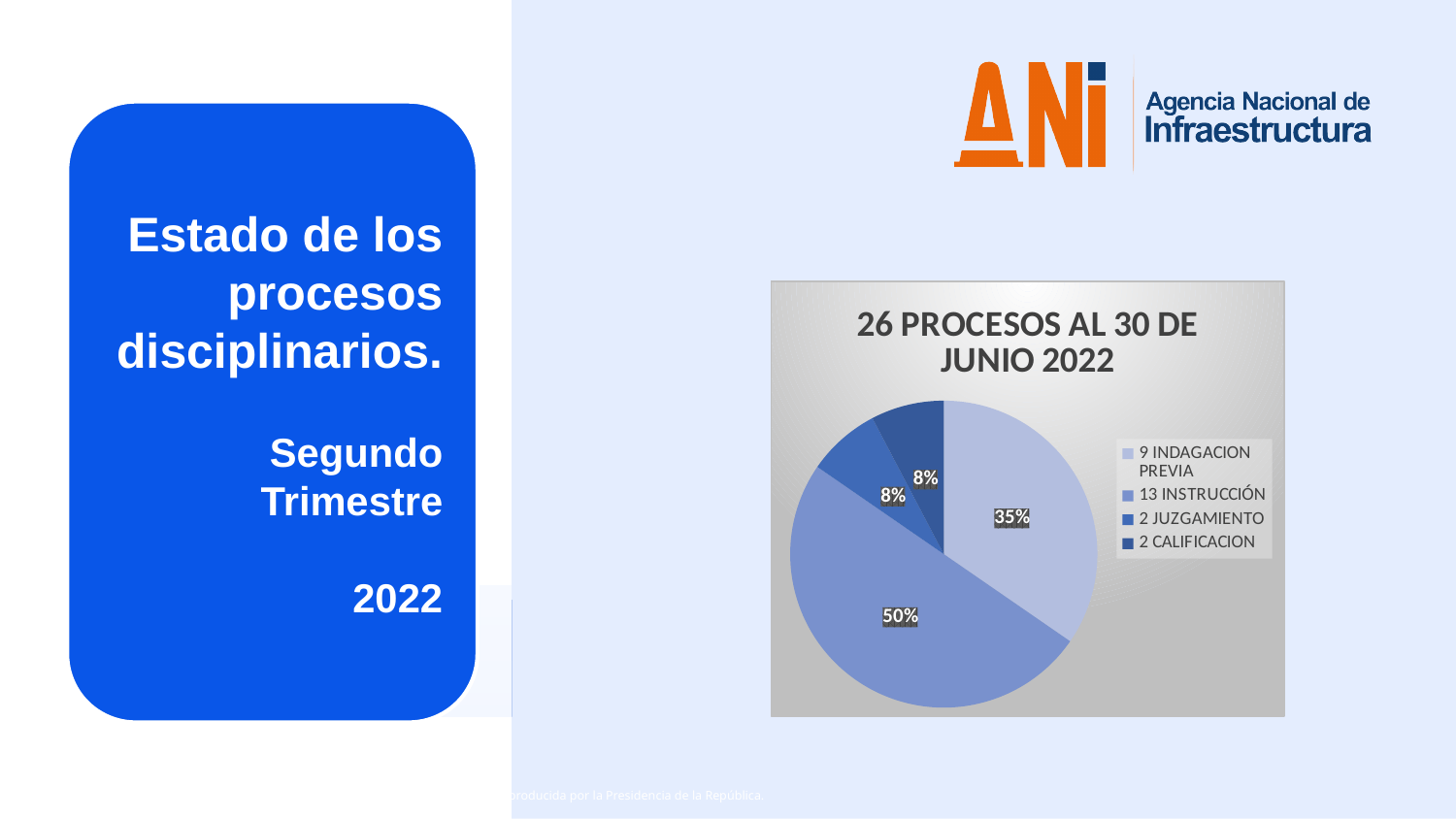
What percentage of the pie does CALIFICACION represent? 8% What percentage of the pie does INSTRUCCIÓN represent? 50% What percentage of the pie does INDAGACION PREVIA represent? 35% What is the title of the chart? 26 PROCESOS AL 30 DE JUNIO 2022 According to the legend, how many processes are in INDAGACION PREVIA? 9 What is the difference in percentage points between the INSTRUCCIÓN share and the INDAGACION PREVIA share? 15 Which is larger, the share for INDAGACION PREVIA or the share for INSTRUCCIÓN? INSTRUCCIÓN According to the legend, how many processes are in INSTRUCCIÓN? 13 Which category has the largest share of the pie? INSTRUCCIÓN What kind of chart is shown on the slide? Pie chart How many slices does the pie chart have? 4